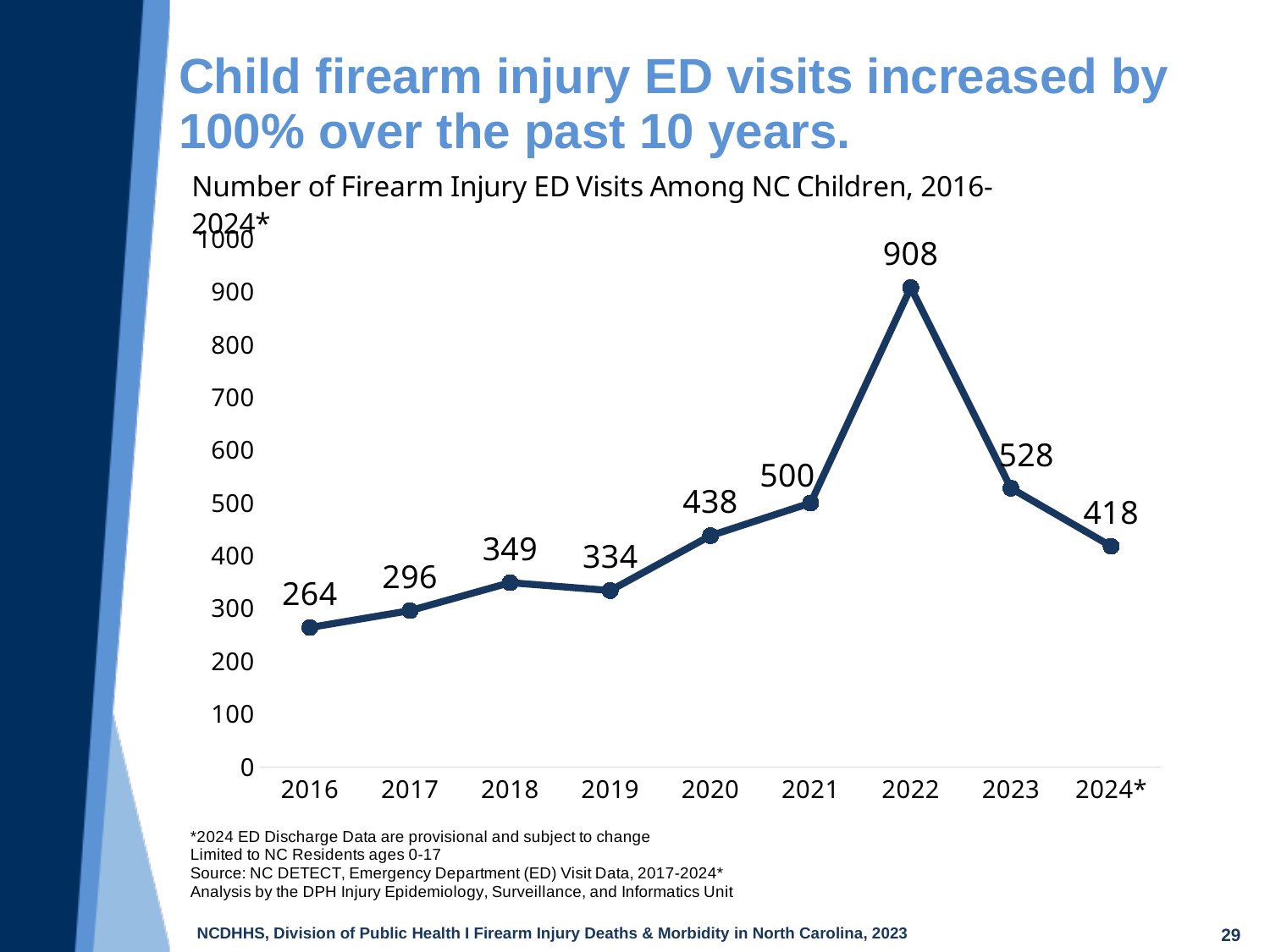
How many years (data points) are plotted on the chart? 9 Which year had the highest number of firearm injury ED visits? 2022 Which year had more ED visits, 2018 or 2019? 2018 What is the difference between the 2022 value and the 2023 value? 380 What type of chart is shown on the slide? line chart What was the number of firearm injury ED visits in 2016? 264 What is the difference between the 2024* value and the 2016 value? 154 Did the number of ED visits rise or fall from 2022 to 2024*? fall How many firearm injury ED visits among NC children were there in 2022? 908 What value is shown for 2024*? 418 Which year had the lowest number of firearm injury ED visits? 2016 What is the title of the chart? Number of Firearm Injury ED Visits Among NC Children, 2016-2024*